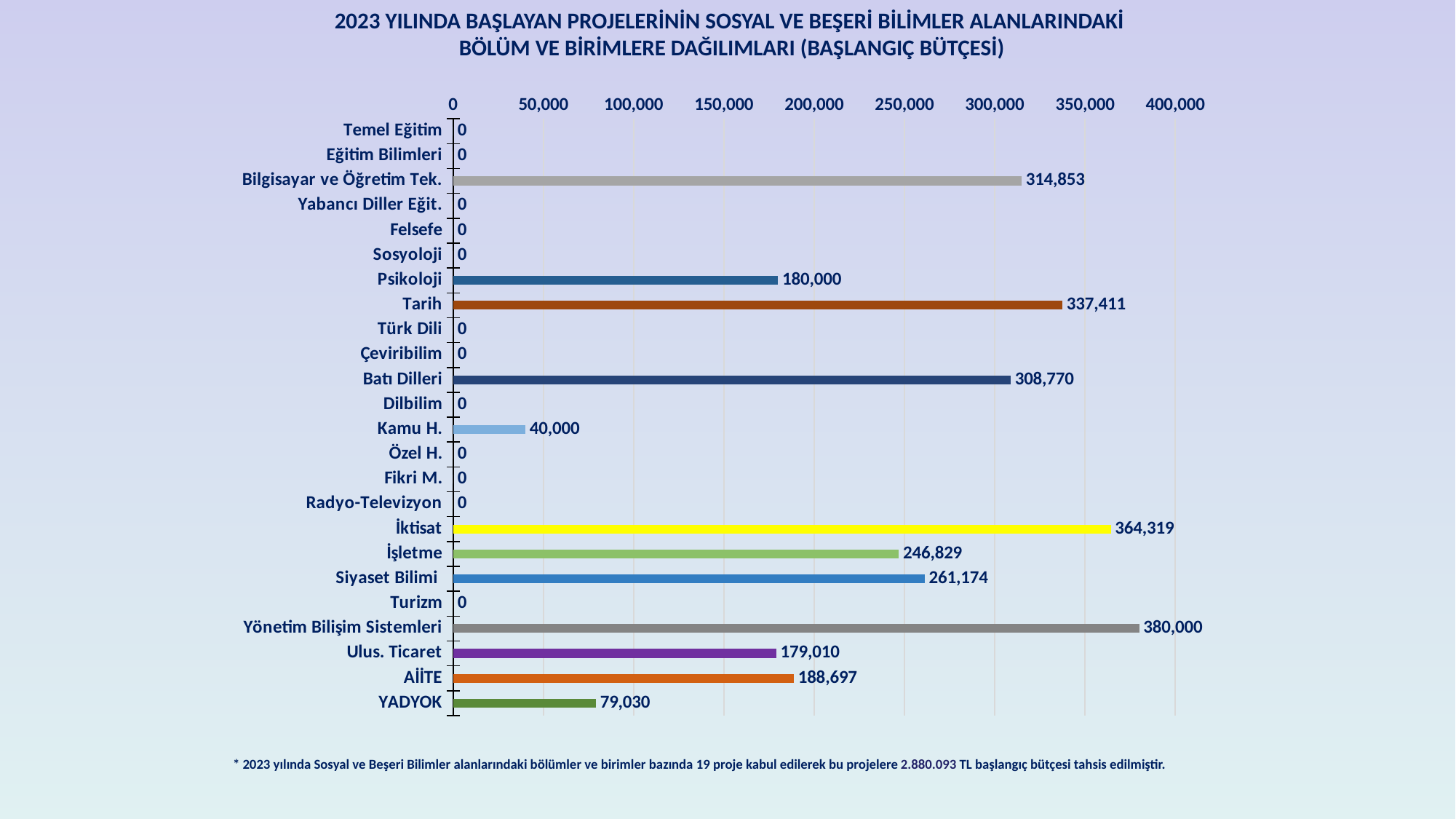
Which has the larger value, Tarih or Bilgisayar ve Öğretim Tek.? Tarih How many categories have a value greater than 0? 12 Which category has the highest value? Yönetim Bilişim Sistemleri What is the value for YADYOK? 79,030 What kind of chart is shown on the slide? Bar chart What is the difference between the values for Tarih and Psikoloji? 157,411 How many categories are shown on the chart? 24 What is the value for Yönetim Bilişim Sistemleri? 380,000 What is the difference between the values for İktisat and İşletme? 117,490 Which has the larger value, Psikoloji or Ulus. Ticaret? Psikoloji What is the value for Kamu H.? 40,000 What is the value for Tarih? 337,411